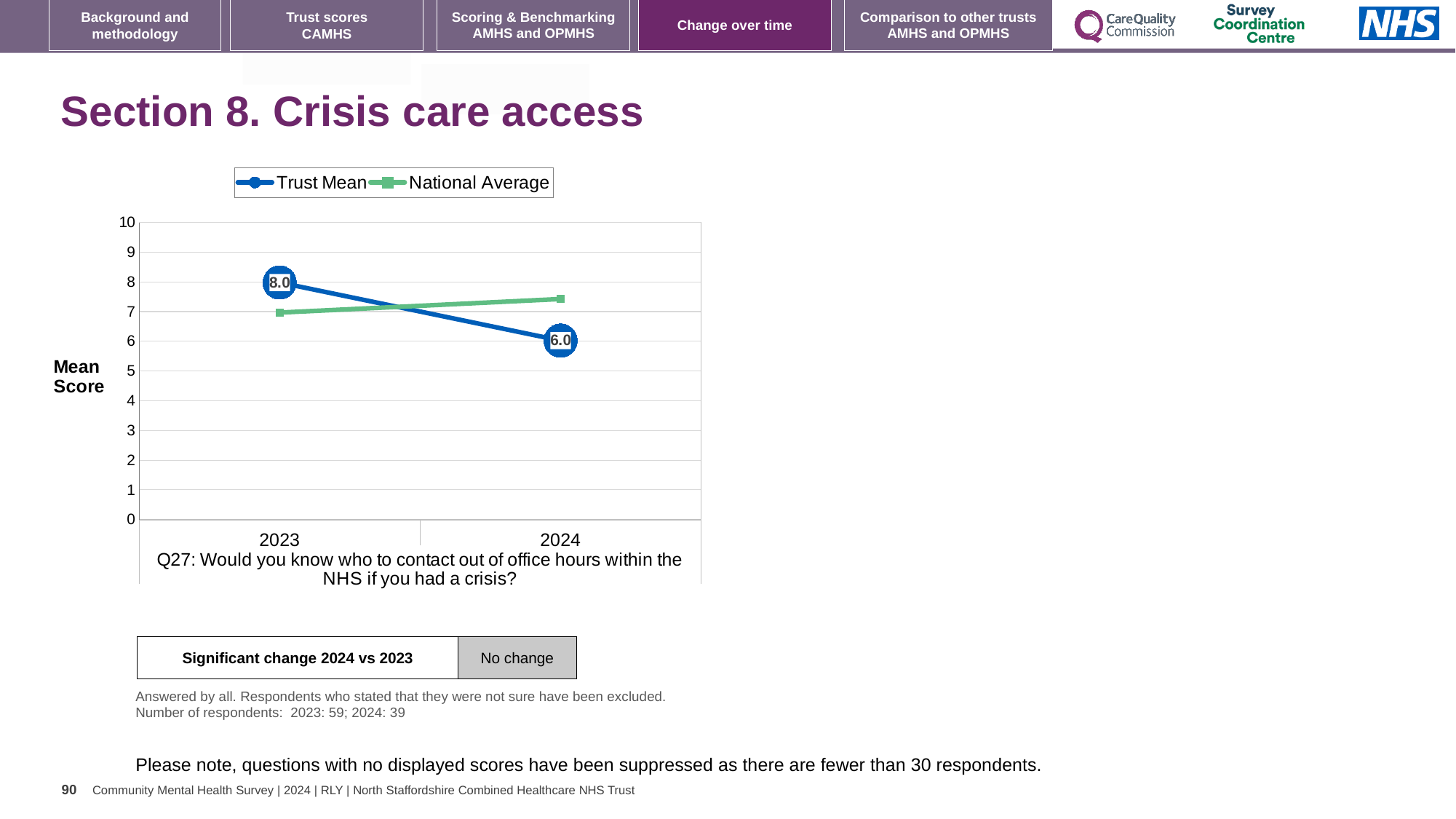
Is the National Average value for 2024 greater or less than 7? greater In 2024, which is larger: the Trust Mean or the National Average? National Average In which year is the Trust Mean lowest? 2024 What is the difference between the Trust Mean in 2023 and in 2024? 2.0 In which year is the Trust Mean highest? 2023 Is the National Average value for 2023 greater or less than 8? less What is the Trust Mean value for 2023? 8.0 How many series does the legend list? 2 What kind of chart is shown on the slide? Line chart In 2023, which is larger: the Trust Mean or the National Average? Trust Mean What is the Trust Mean value for 2024? 6.0 Does the Trust Mean rise or fall from 2023 to 2024? Fall